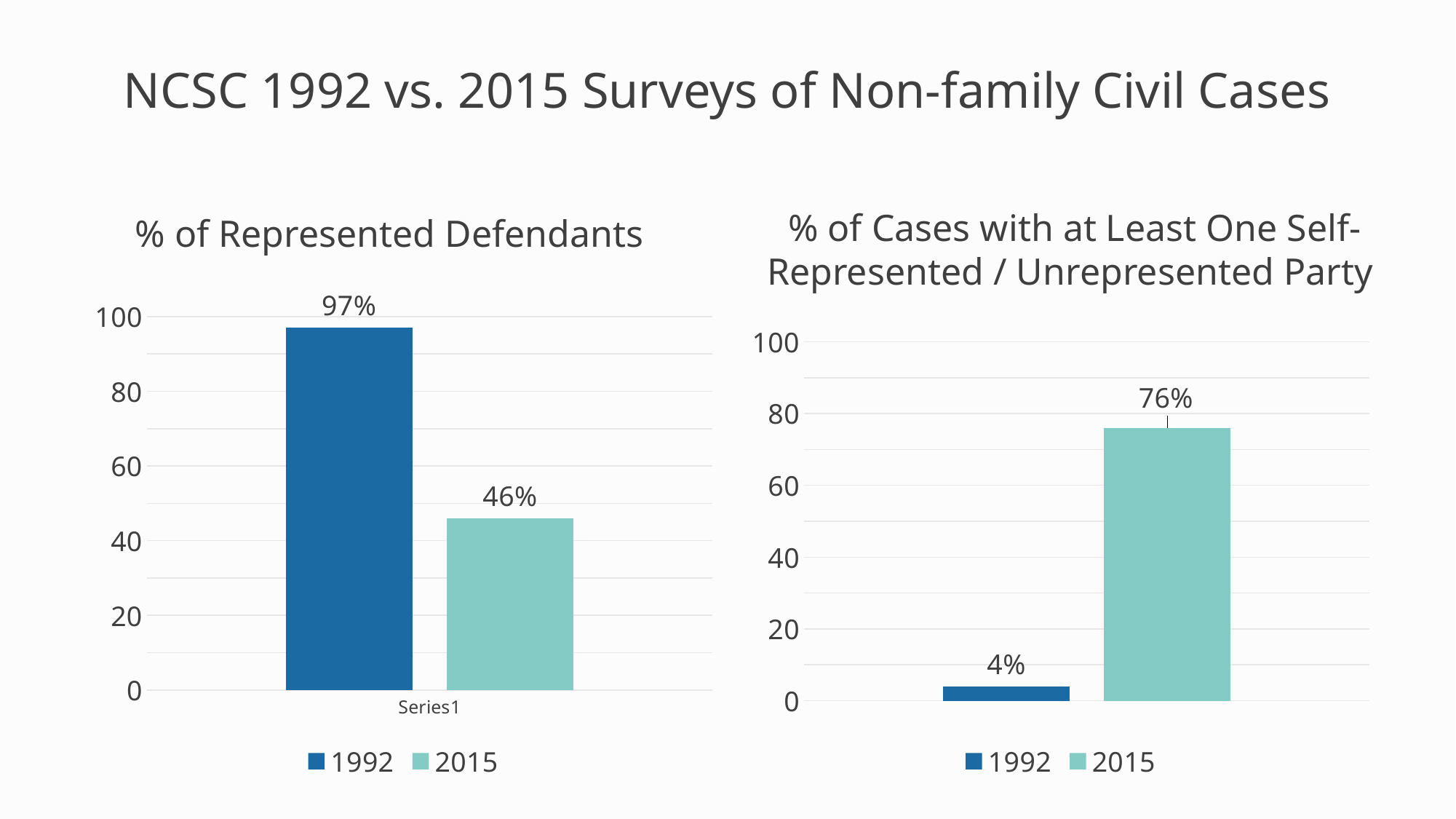
In the '% of Represented Defendants' chart, what is the difference between the 1992 and 2015 values? 51% In the '% of Cases with at Least One Self-Represented / Unrepresented Party' chart, is the value for 2015 greater or less than 60? greater In the '% of Cases with at Least One Self-Represented / Unrepresented Party' chart, what is the value for 1992? 4% What is the title of the slide? NCSC 1992 vs. 2015 Surveys of Non-family Civil Cases In the '% of Represented Defendants' chart, which year has the higher value? 1992 In the '% of Cases with at Least One Self-Represented / Unrepresented Party' chart, what is the difference between the 2015 and 1992 values? 72% In the '% of Cases with at Least One Self-Represented / Unrepresented Party' chart, what is the value for 2015? 76% In the '% of Represented Defendants' chart, what is the value for 2015? 46% What type of chart is the '% of Cases with at Least One Self-Represented / Unrepresented Party' chart? Bar chart How many series does the legend of the '% of Represented Defendants' chart list? 2 In the '% of Represented Defendants' chart, what is the value for 1992? 97% In the '% of Cases with at Least One Self-Represented / Unrepresented Party' chart, which year has the lower value? 1992